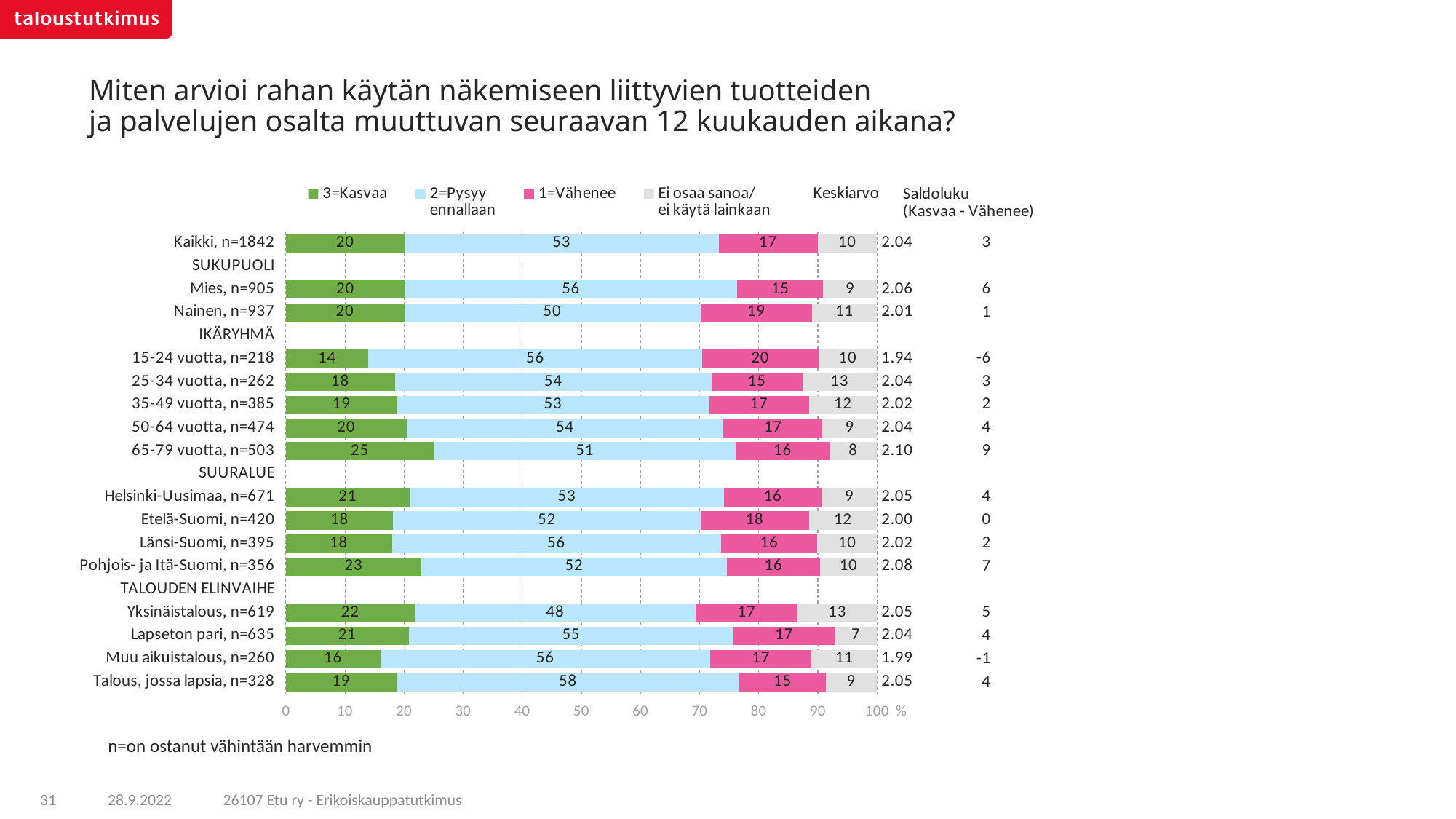
Which category has the highest value for 3=Kasvaa? 65-79 vuotta, n=503 What is the Keskiarvo for 65-79 vuotta, n=503? 2.10 Which category has the lowest value for 3=Kasvaa? 15-24 vuotta, n=218 What is the value of 2=Pysyy ennallaan for Talous, jossa lapsia, n=328? 58 How many series does the legend list? 4 What colour represents 3=Kasvaa in the chart? Green What is the difference between the 2=Pysyy ennallaan and 1=Vähenee values for Kaikki, n=1842? 36 Which category has the lowest value for Ei osaa sanoa/ei käytä lainkaan? Lapseton pari, n=635 What kind of chart is shown on the slide? Stacked bar chart Which has a larger value for 2=Pysyy ennallaan, Mies, n=905 or Nainen, n=937? Mies, n=905 What is the value of 3=Kasvaa for Kaikki, n=1842? 20 What is the Saldoluku (Kasvaa - Vähenee) for 15-24 vuotta, n=218? -6